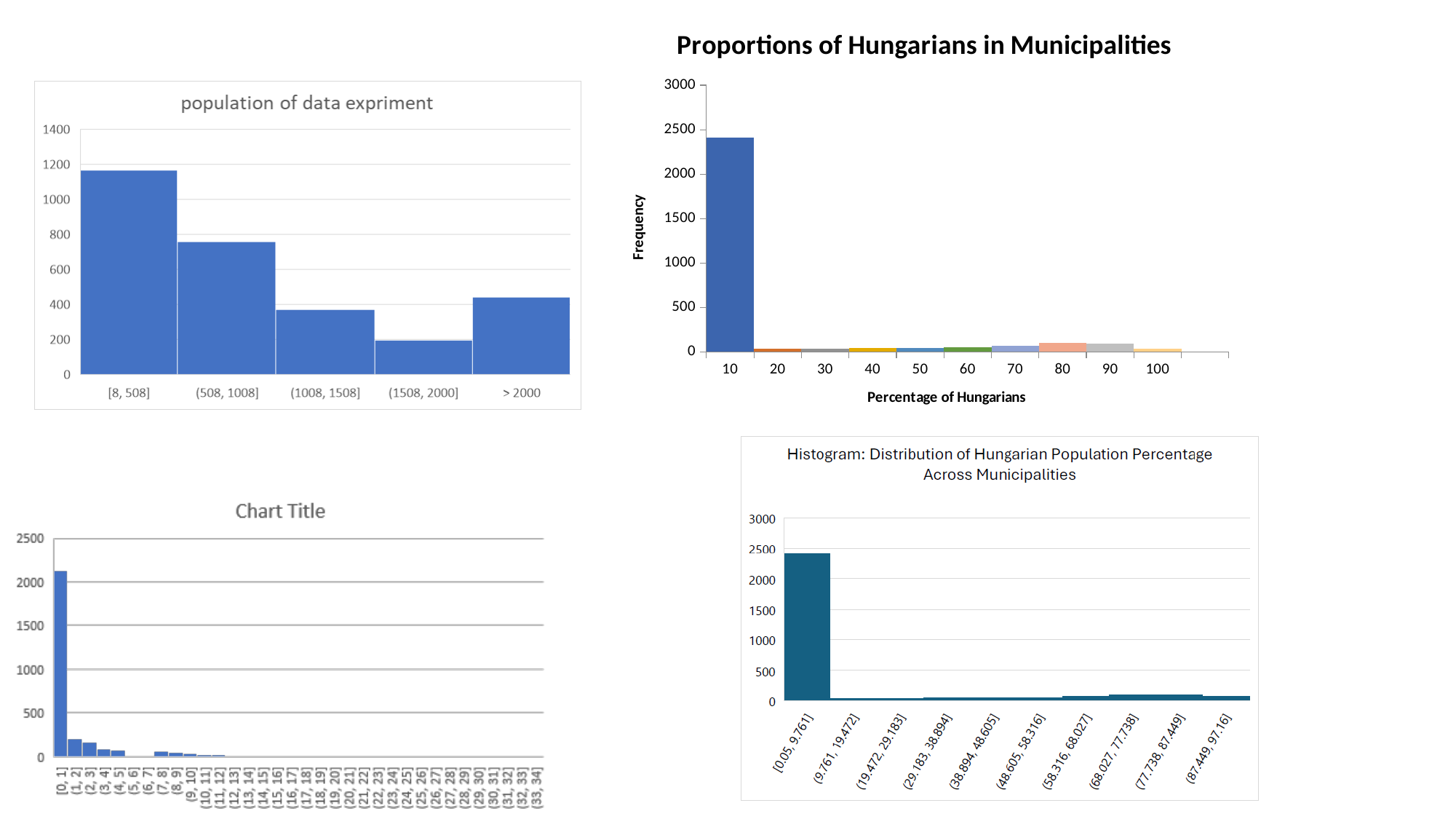
What type of chart is the bottom-left chart titled 'Chart Title'? bar chart In the 'population of data expriment' chart, is the value for [8, 508] greater or less than 1000? greater What is the y-axis label of the 'Proportions of Hungarians in Municipalities' chart? Frequency In the 'population of data expriment' chart, is the value for (1508, 2000] greater or less than 400? less In the 'population of data expriment' chart, which category has the lowest value? (1508, 2000] In the 'Proportions of Hungarians in Municipalities' chart, which x-axis category has the highest frequency? 10 In the 'population of data expriment' chart, which is larger: the value for (1008, 1508] or the value for > 2000? > 2000 In the 'Proportions of Hungarians in Municipalities' chart, is the frequency for 10 greater or less than 2000? greater How many categories are shown in the 'population of data expriment' chart? 5 How many bins are shown in the 'Histogram: Distribution of Hungarian Population Percentage Across Municipalities' chart? 10 In the 'population of data expriment' chart, which category has the highest value? [8, 508] In the 'Histogram: Distribution of Hungarian Population Percentage Across Municipalities' chart, which bin has the highest value? [0.05, 9.761]